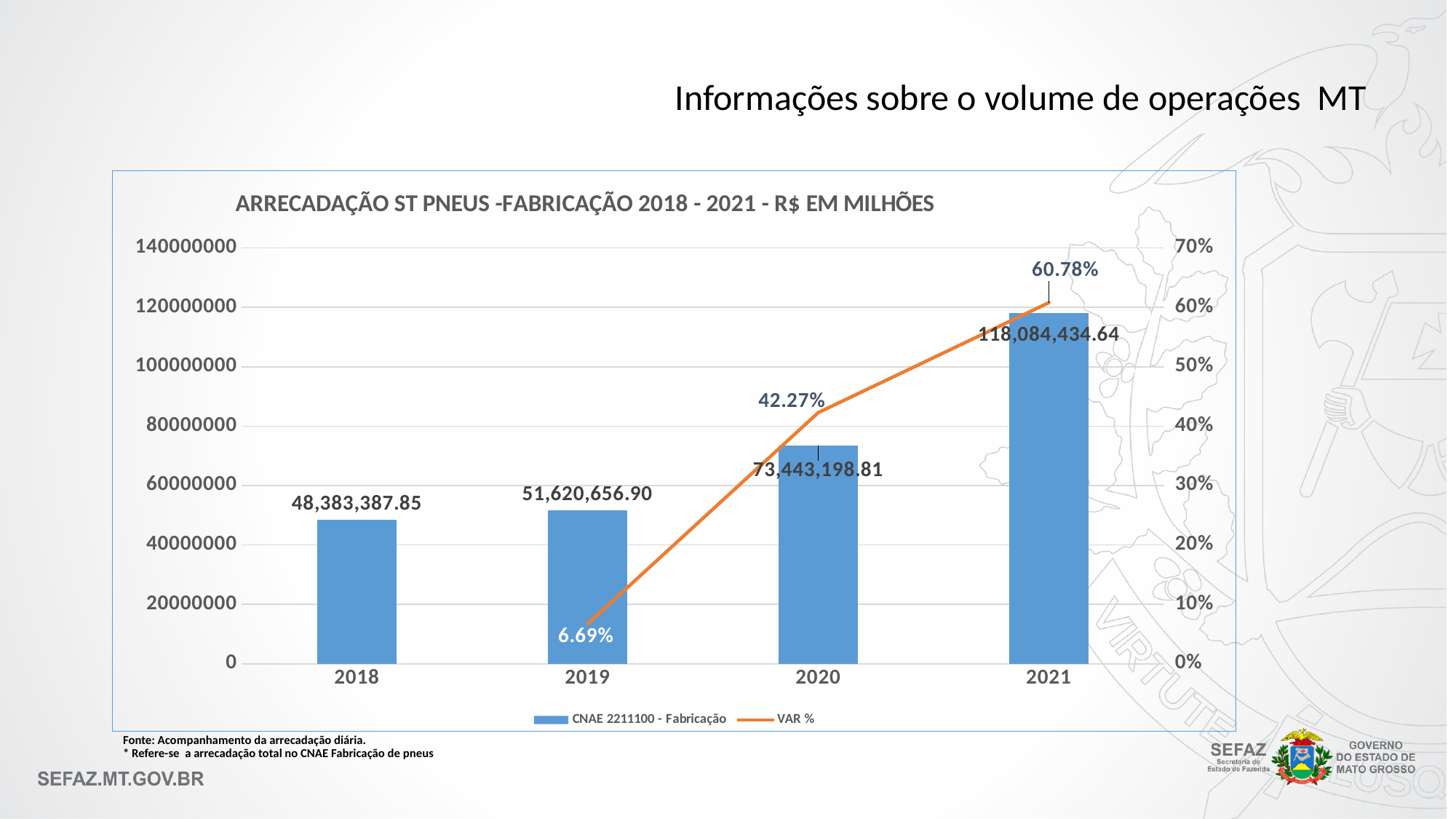
How many years are shown on the x axis of the chart? 4 What is the value of the CNAE 2211100 - Fabricação bar for 2018? 48,383,387.85 What is the VAR % value shown for 2020? 42.27% What is the title of the chart? ARRECADAÇÃO ST PNEUS -FABRICAÇÃO 2018 - 2021 - R$ EM MILHÕES Which year has the highest CNAE 2211100 - Fabricação value? 2021 What is the difference between the CNAE 2211100 - Fabricação values for 2021 and 2020? 44,641,235.83 What is the value of the CNAE 2211100 - Fabricação bar for 2021? 118,084,434.64 Which year has the lowest CNAE 2211100 - Fabricação value? 2018 Do the CNAE 2211100 - Fabricação values rise or fall from 2018 to 2021? rise How many series does the legend list? 2 Which is larger, the CNAE 2211100 - Fabricação value for 2019 or for 2020? 2020 What is the VAR % value shown for 2019? 6.69%